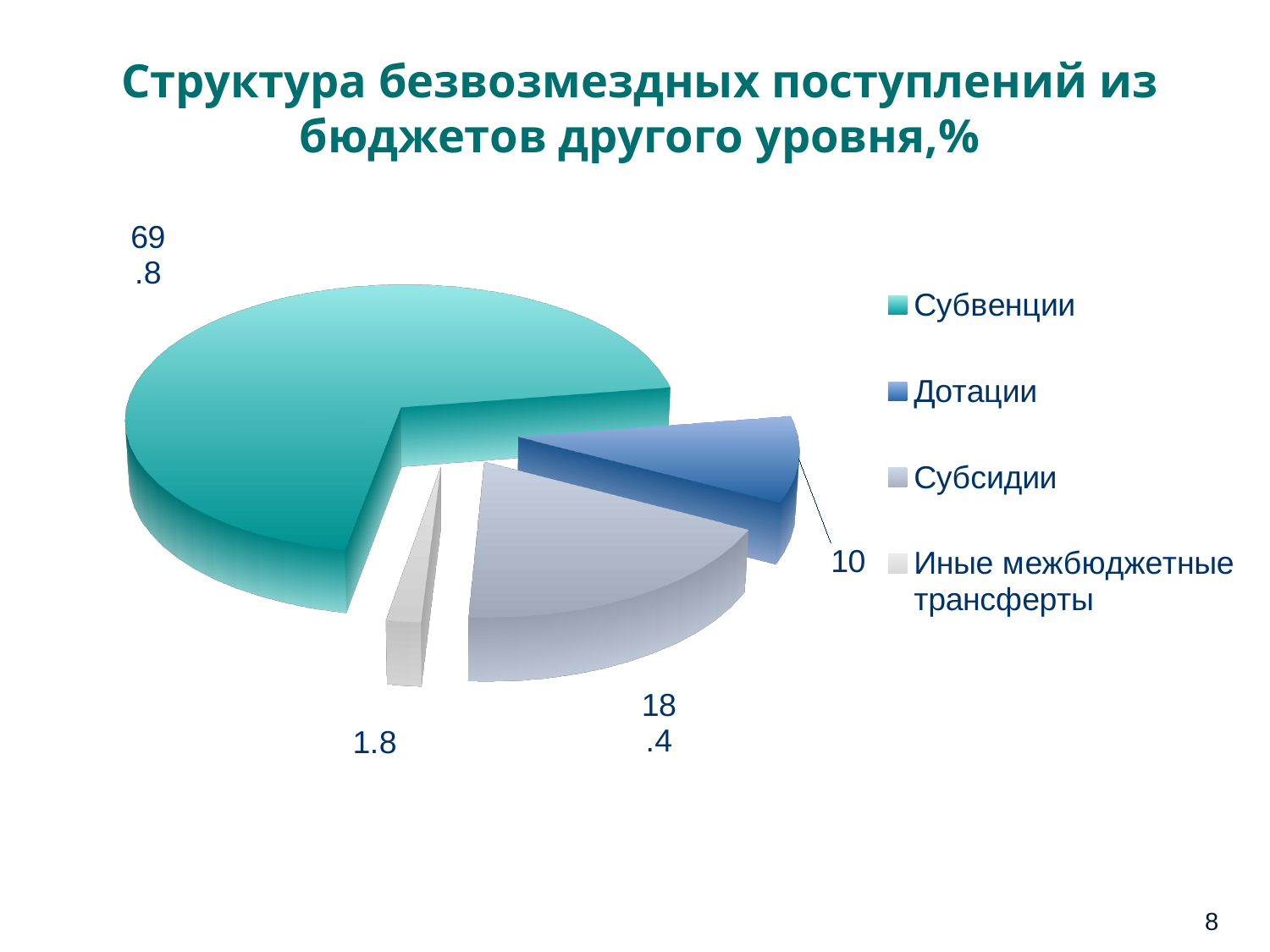
Which category has the largest share of the pie? Субвенции How many categories does the pie chart have? 4 What is the value for Субвенции? 69.8 What is the difference between the values for Субвенции and Субсидии? 51.4 What is the value for Субсидии? 18.4 What is the value for Дотации? 10 What is the title of the chart? Структура безвозмездных поступлений из бюджетов другого уровня,% Which is larger, the value for Дотации or the value for Субсидии? Субсидии What is the difference between the values for Субсидии and Дотации? 8.4 What kind of chart is shown on the slide? pie chart Which category has the smallest share of the pie? Иные межбюджетные трансферты What is the value for Иные межбюджетные трансферты? 1.8